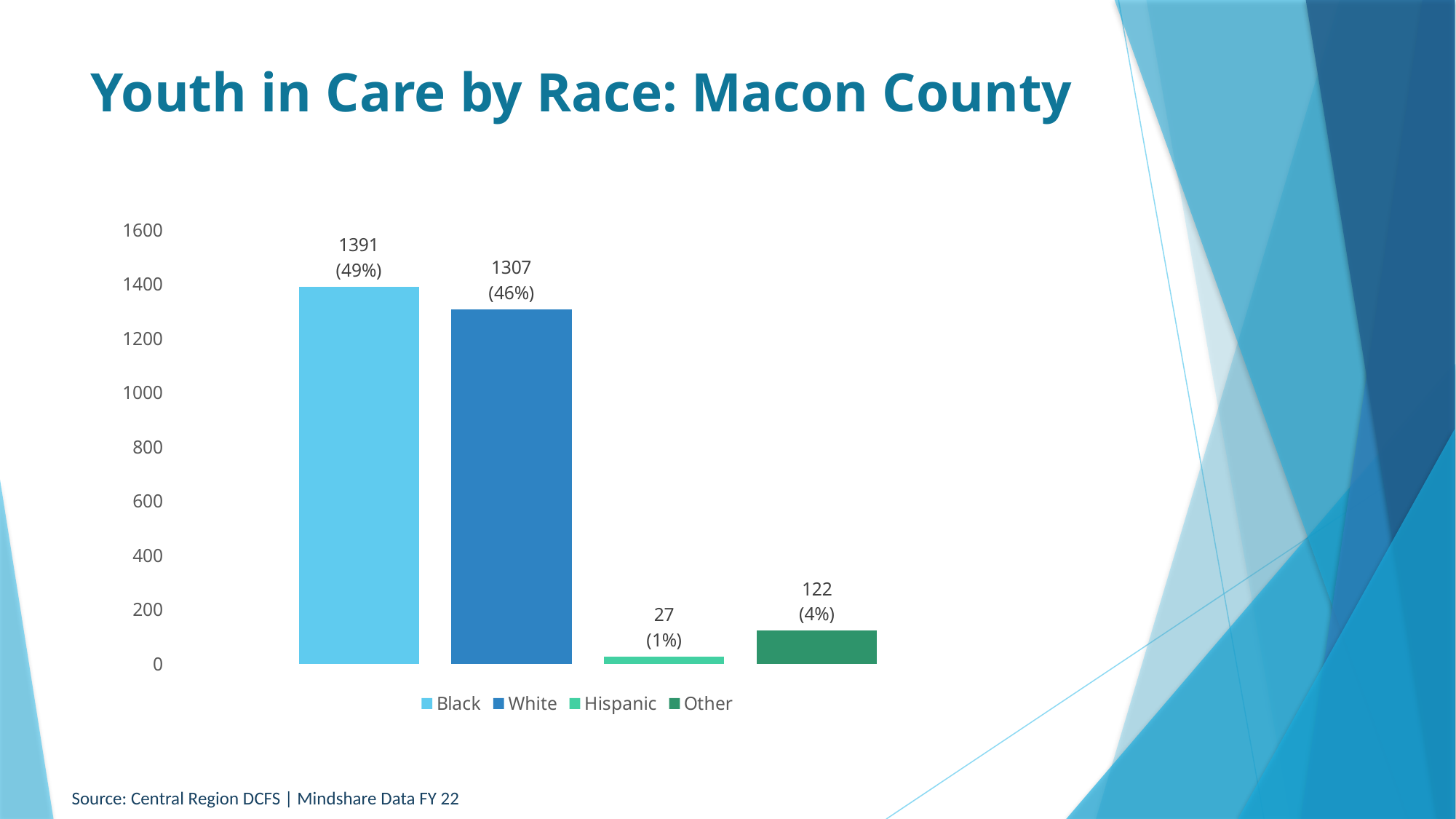
What is the title of the slide? Youth in Care by Race: Macon County Which is larger, the value for White or the value for Other? White What is the number of youth in care for White youth? 1307 What is the number of youth in care for Hispanic youth? 27 What is the difference between the Black and White values? 84 What percentage is shown for the Other category? 4% Which category has the highest number of youth in care? Black What kind of chart is shown on the slide? Bar chart How many categories are shown in the chart? 4 Which category has the lowest number of youth in care? Hispanic What is the difference between the Other and Hispanic values? 95 What is the number of youth in care for Black youth? 1391